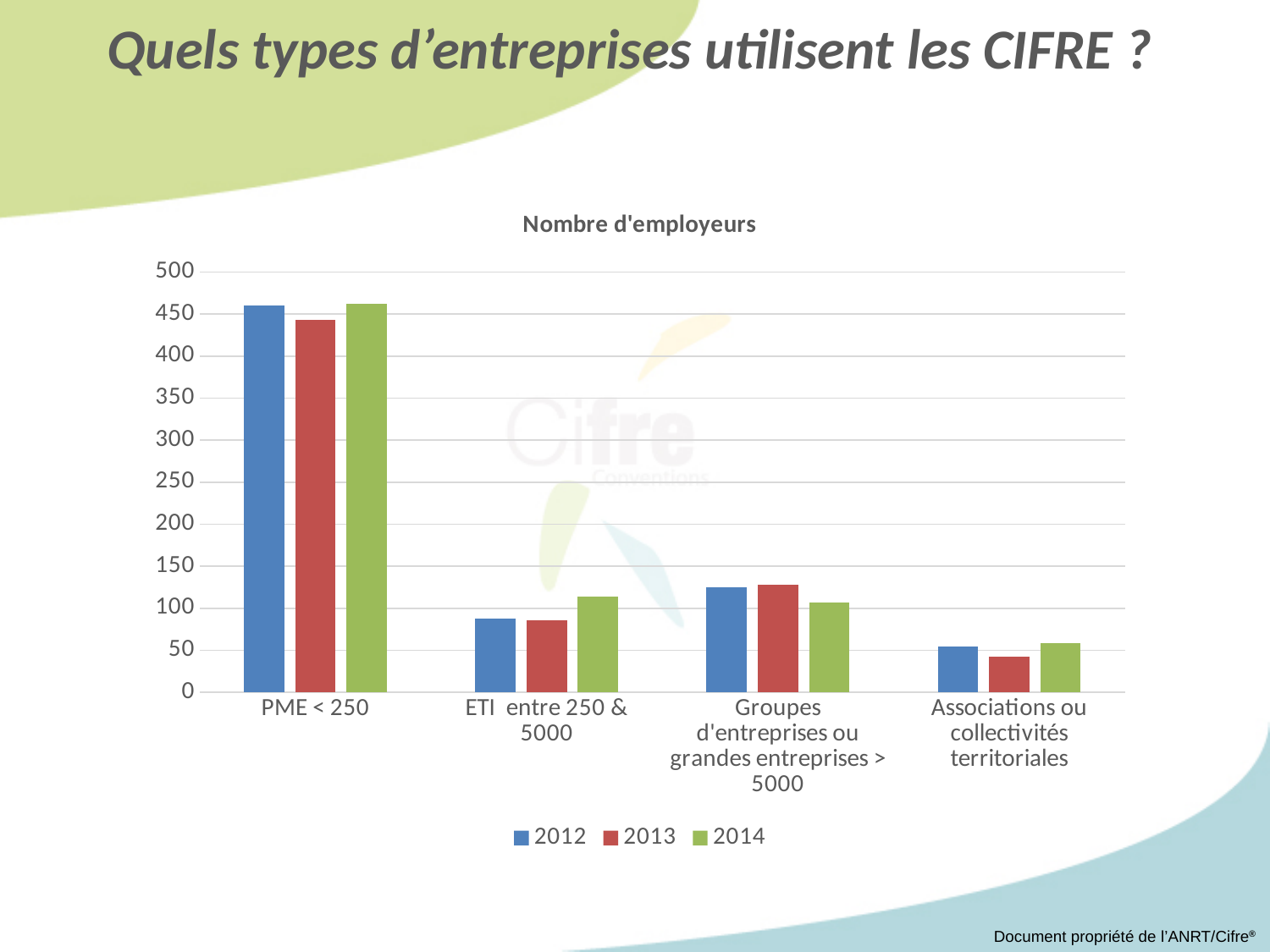
Which category has the lowest number of employers in 2013? Associations ou collectivités territoriales What is the title of the chart? Nombre d'employeurs Is the 2013 value for PME < 250 greater or less than 400? greater Is the 2012 value for ETI entre 250 & 5000 greater or less than 100? less Which colour represents the 2013 series in the legend? red For ETI entre 250 & 5000, which year has the larger value, 2012 or 2014? 2014 Which category has the highest number of employers in 2014? PME < 250 How many series does the legend list? 3 How many employer categories are shown on the x axis? 4 Is the 2013 value for Associations ou collectivités territoriales greater or less than 50? less What type of chart is shown on the slide? bar chart For Groupes d'entreprises ou grandes entreprises > 5000, which year has the larger value, 2013 or 2014? 2013